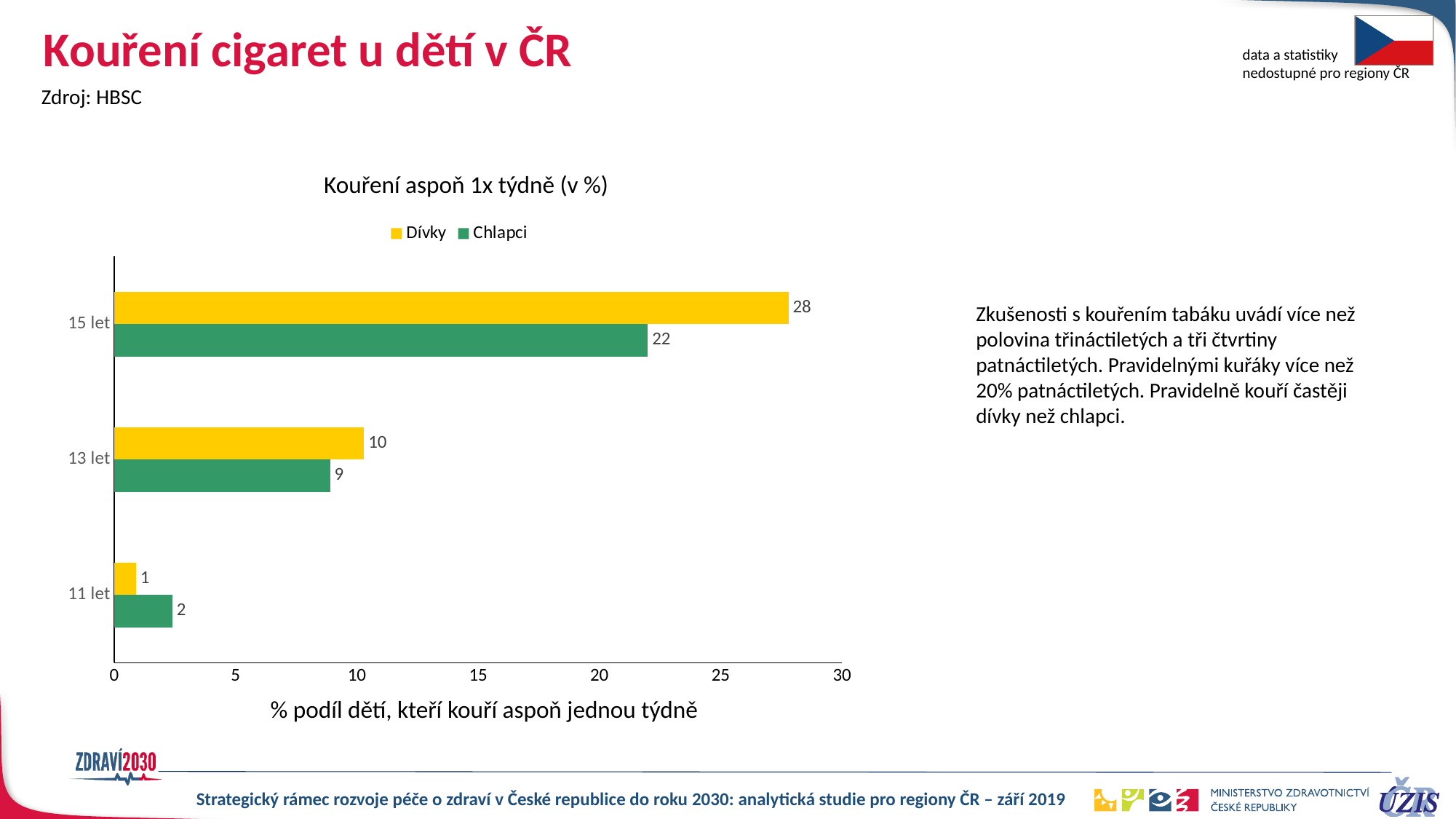
What is the value for Dívky at 15 let? 28 What is the value for Chlapci at 11 let? 2 What is the value for Chlapci at 13 let? 9 What is the difference between Dívky and Chlapci at 15 let? 6 Which is larger at 11 let, Dívky or Chlapci? Chlapci How many series does the legend list? 2 How many age groups are shown on the chart? 3 What is the title of the chart? Kouření aspoň 1x týdně (v %) Which age group has the highest value for Dívky? 15 let Is the value for Chlapci at 15 let greater or less than 20? greater Which age group has the lowest value for Chlapci? 11 let What kind of chart is shown? bar chart